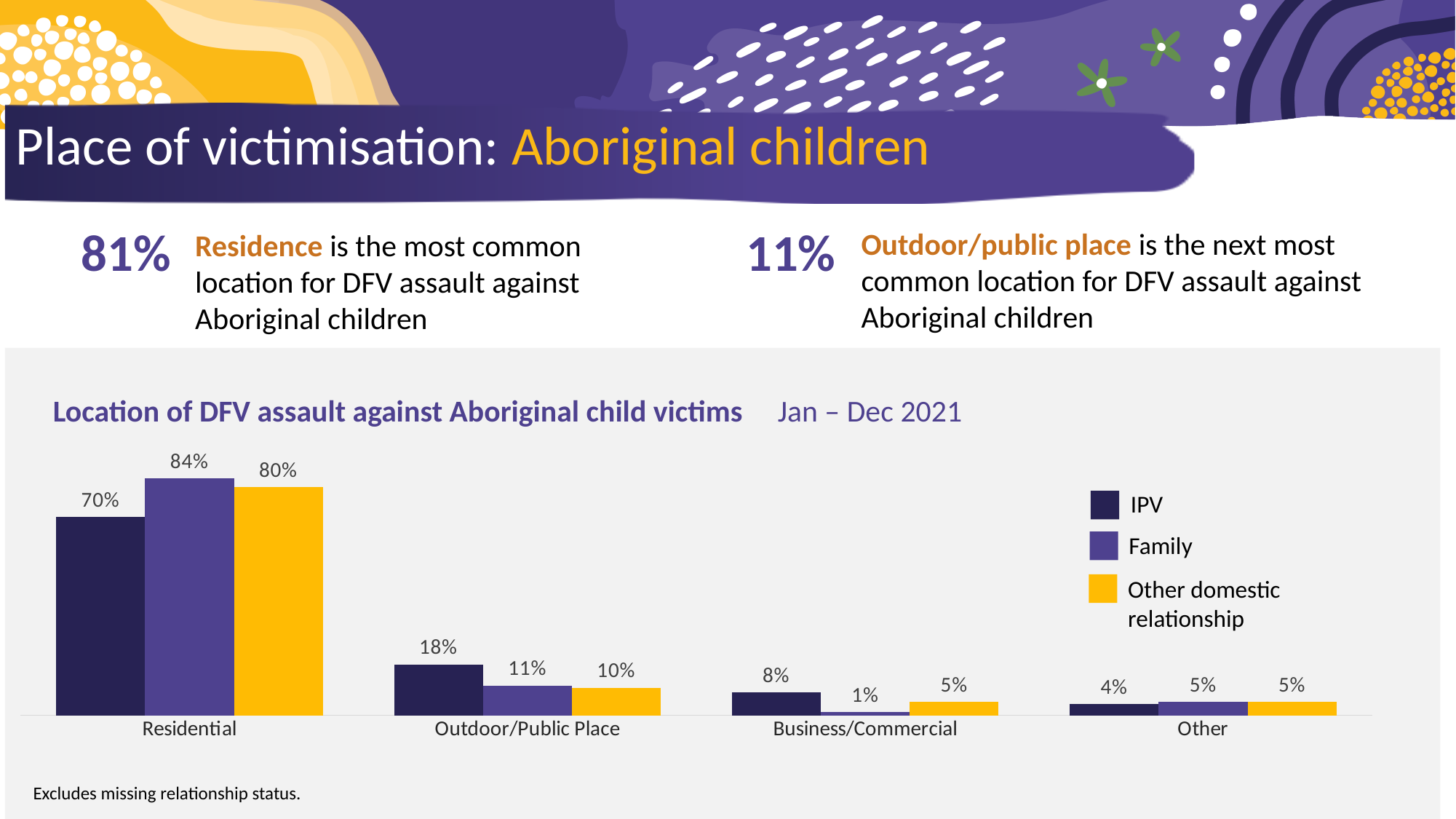
Which series is shown in yellow? Other domestic relationship What kind of chart is shown? Bar chart What is the Family value for Outdoor/Public Place? 11% Which is larger for Outdoor/Public Place: the IPV value or the Other domestic relationship value? IPV What is the difference between the Family and IPV values for Residential? 14% Which location has the highest Family value? Residential What is the Other domestic relationship value for Business/Commercial? 5% What is the title of the chart? Location of DFV assault against Aboriginal child victims How many location categories are shown on the x axis? 4 Which location has the lowest IPV value? Other What is the IPV value for Residential? 70% How many series does the legend list? 3